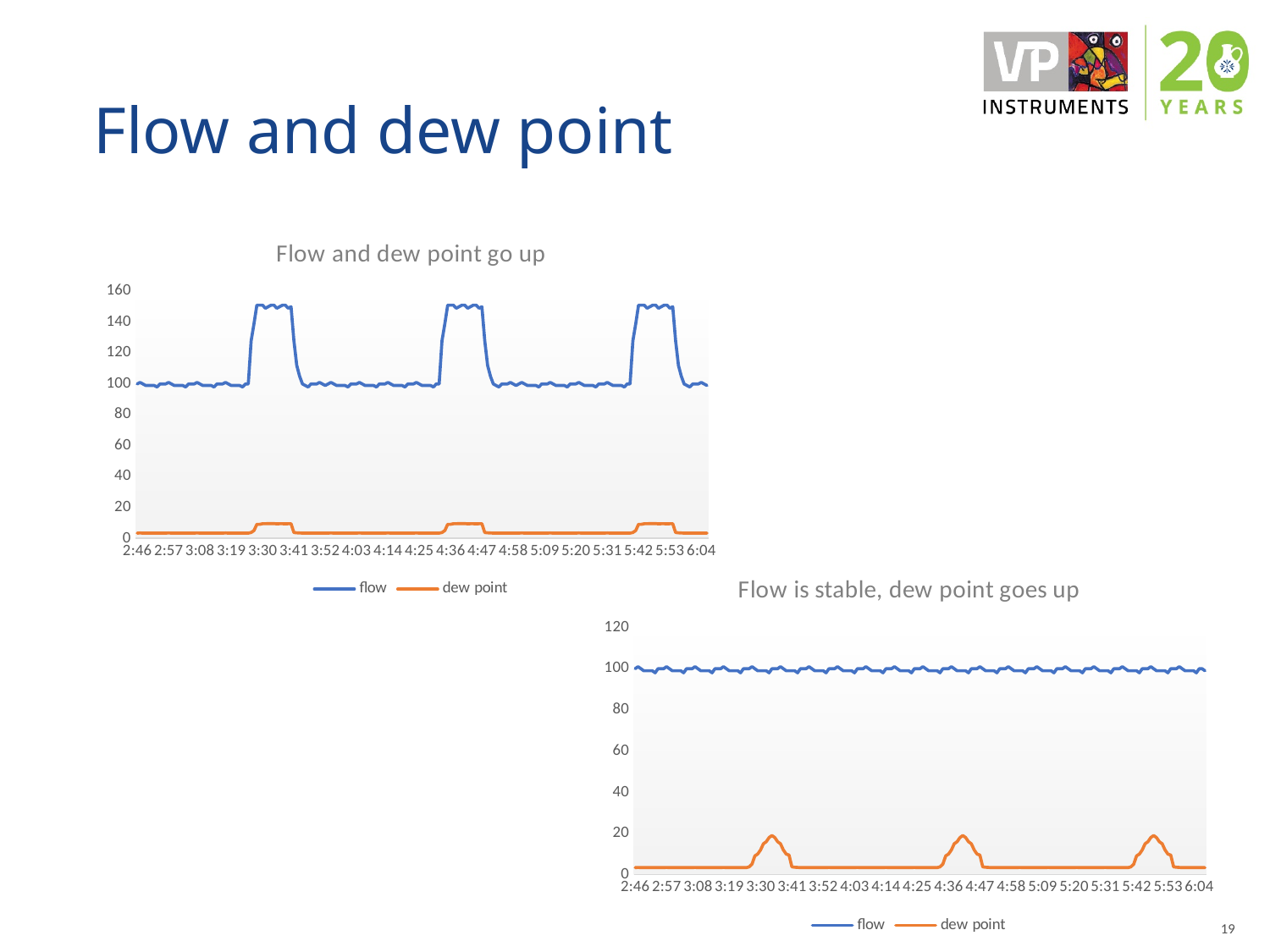
What is the title of the chart in the lower right of the slide? Flow is stable, dew point goes up In the chart titled "Flow and dew point go up", is the dew point value at 2:46 greater or less than 20? less How many time labels are shown on the x axis of the chart titled "Flow is stable, dew point goes up"? 19 What kind of chart is the chart titled "Flow and dew point go up"? line chart How many series does the legend of the chart titled "Flow is stable, dew point goes up" list? 2 In the chart titled "Flow is stable, dew point goes up", is the dew point value at 3:30 greater or less than 40? less In the chart titled "Flow is stable, dew point goes up", does the flow series rise, fall, or stay roughly flat from 2:46 to 6:04? stays roughly flat In the chart titled "Flow and dew point go up", is the flow value at 3:30 greater or less than 140? greater In the chart titled "Flow and dew point go up", is the flow value larger at 2:46 or at 3:30? 3:30 In the chart titled "Flow is stable, dew point goes up", which series has the larger value at 2:46, flow or dew point? flow In the chart titled "Flow and dew point go up", which series is drawn in orange? dew point